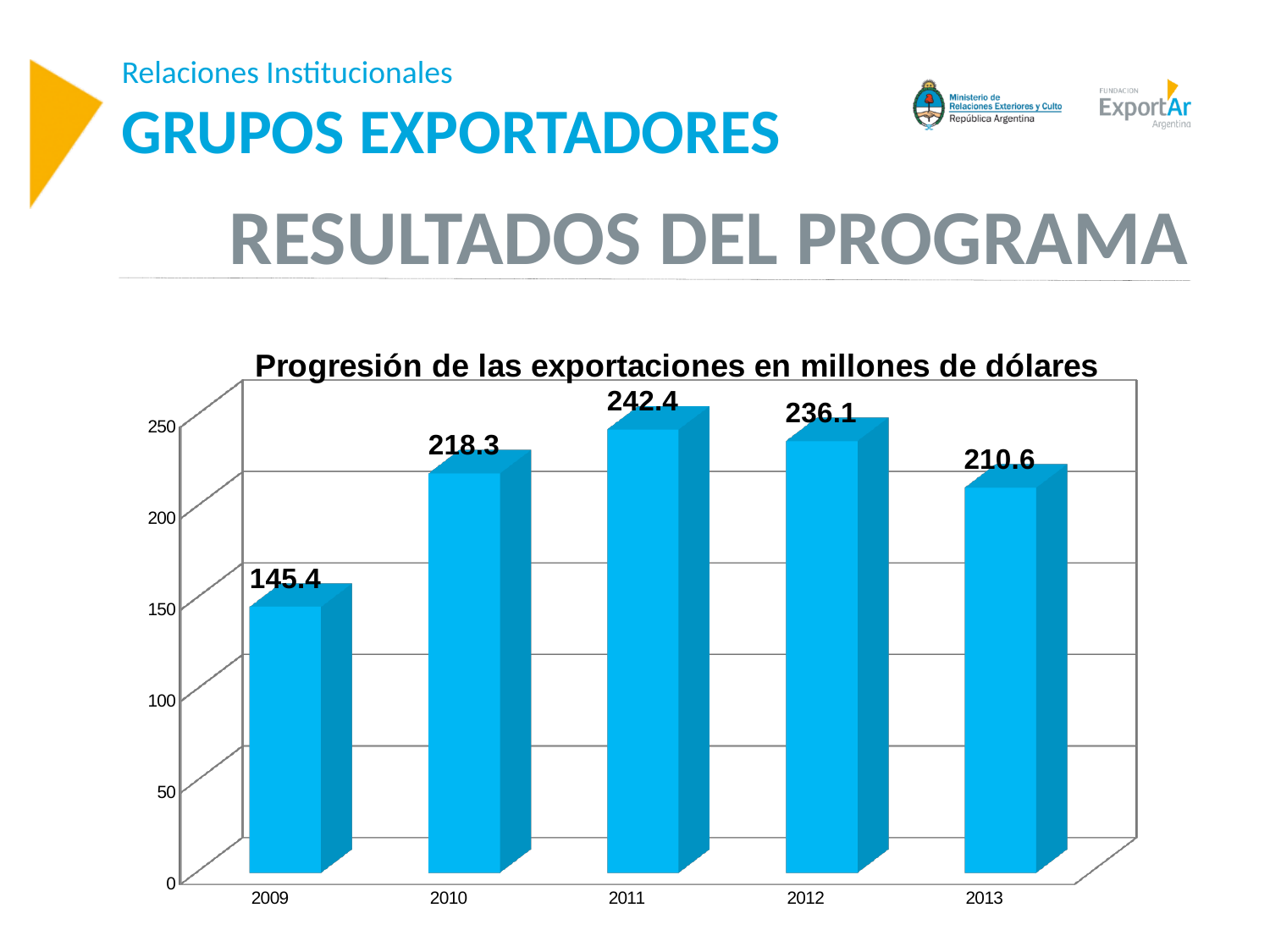
Is the value for 2012 greater or less than 200? greater Which is larger, the value for 2010 or the value for 2013? 2010 What is the value for 2009? 145.4 What kind of chart is shown on the slide? bar chart What is the difference between the values for 2011 and 2012? 6.3 What is the value for 2011? 242.4 What is the value for 2013? 210.6 Which year has the lowest value? 2009 Which year has the highest value? 2011 What is the title of the chart? Progresión de las exportaciones en millones de dólares What is the difference between the values for 2010 and 2009? 72.9 How many years are shown on the x axis? 5